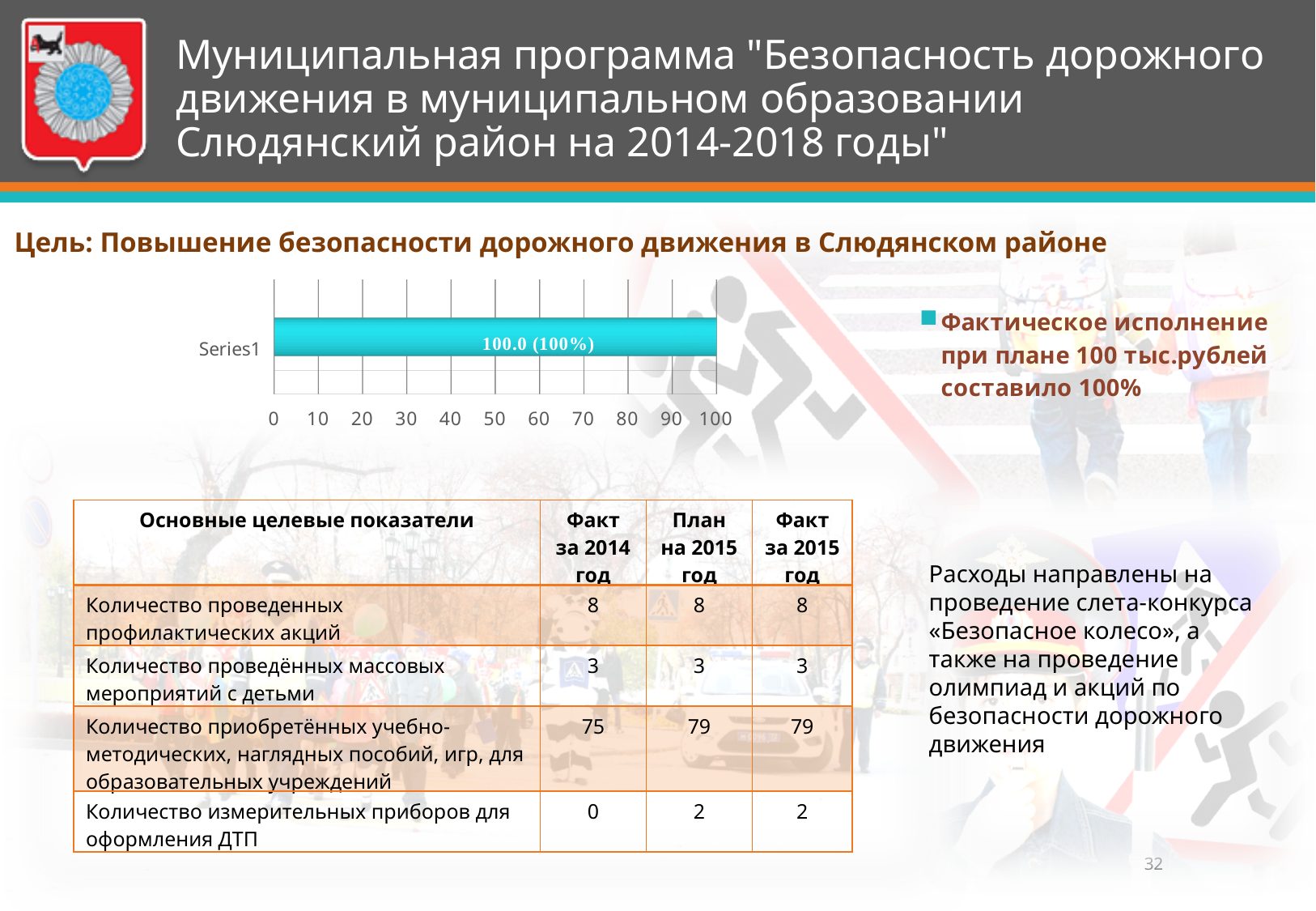
What is the highest value shown on the chart's horizontal axis? 100 How many bars are plotted in the chart? 1 What is the category label shown next to the bar in the chart? Series1 What type of chart is shown on the slide? bar chart Is the value for Series1 greater or less than 50? greater How many series does the chart's legend list? 1 What is the data label shown on the bar for Series1? 100.0 (100%)